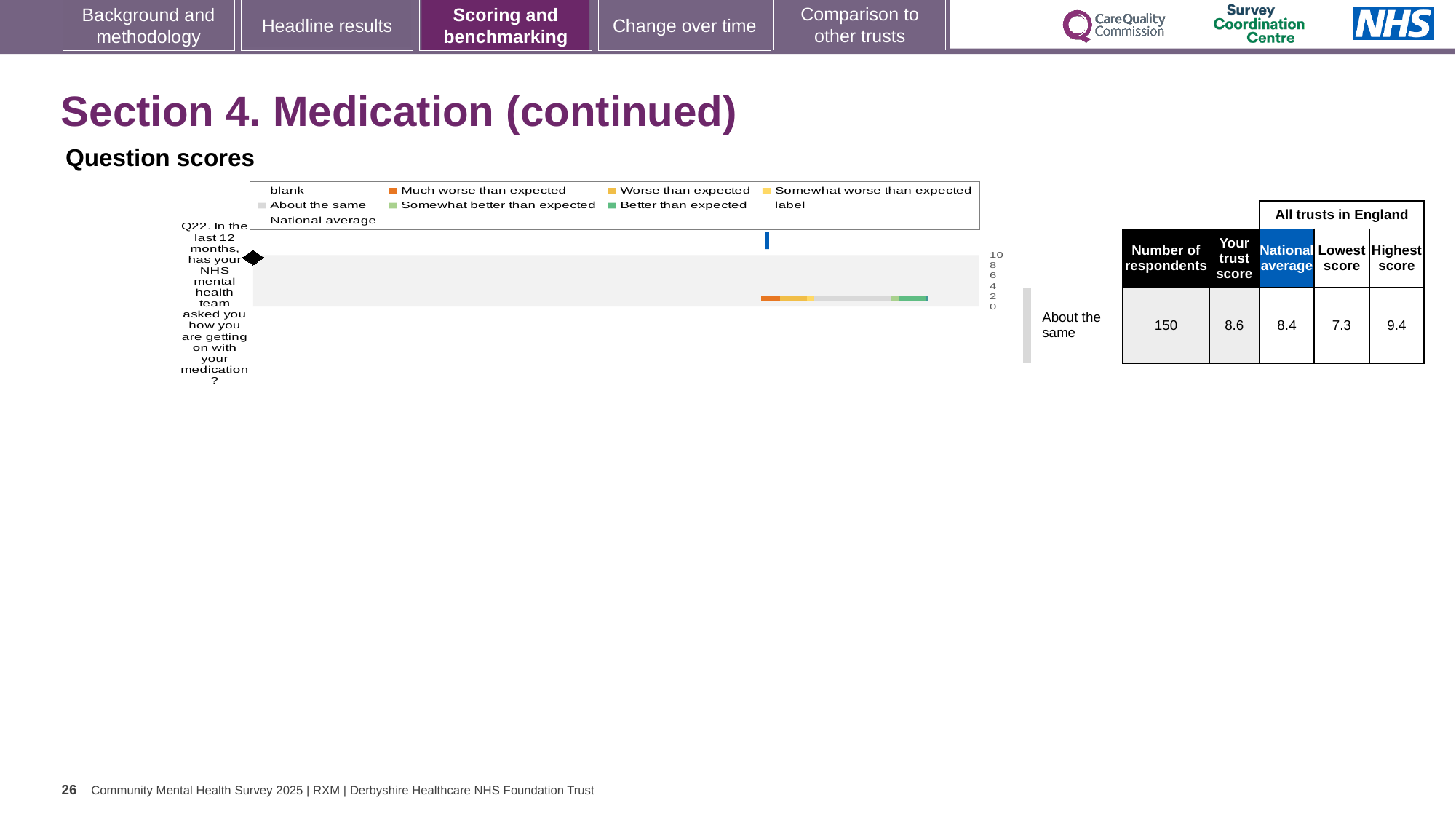
What is the trust's score for Q22? 8.6 Which is larger for Q22, the trust's score or the national average? the trust's score Which benchmarking category is the trust's Q22 score placed in? About the same What is the lowest score among all trusts in England for Q22? 7.3 What is the number of respondents for Q22 in the table next to the chart? 150 What colour does the legend use for 'Much worse than expected'? orange What is the highest score among all trusts in England for Q22? 9.4 By how much does the trust's score for Q22 exceed the national average? 0.2 How many questions are plotted in the Question scores chart? 1 What kind of chart is shown under 'Question scores'? bar chart What is the national average score for Q22? 8.4 What is the difference between the highest and lowest scores for Q22 across all trusts in England? 2.1